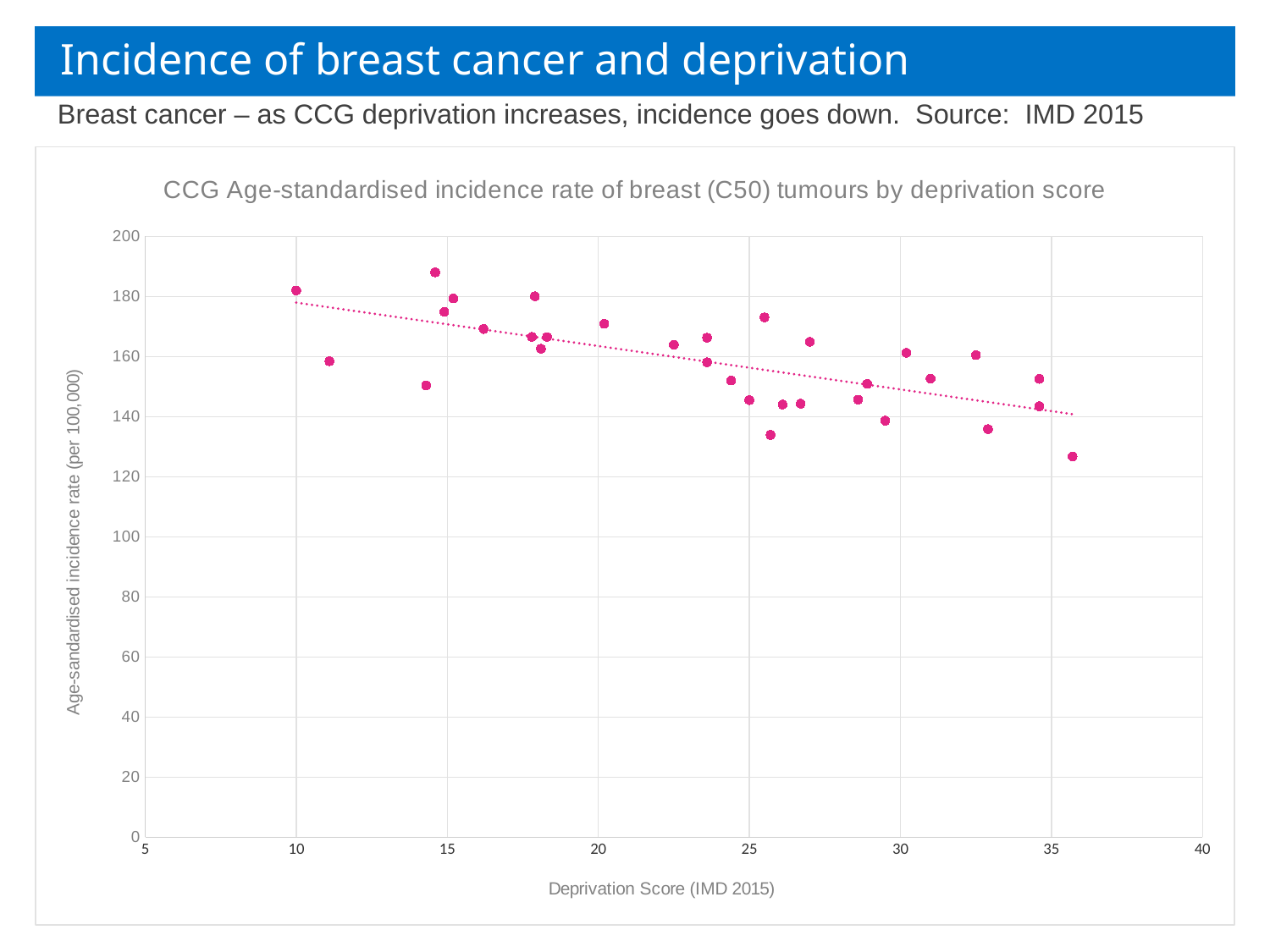
What is the maximum value shown on the y axis? 200 What kind of chart is shown on the slide? Scatter chart Is the incidence rate for the point with the lowest deprivation score (around 10) greater or less than 160? greater What is the title of the chart? CCG Age-standardised incidence rate of breast (C50) tumours by deprivation score Is the highest plotted incidence rate greater or less than 180? greater Is the incidence rate for the point with the highest deprivation score (around 36) greater or less than 140? less Does the dotted trend line slope upward or downward from left to right? Downward As the deprivation score increases along the x axis, do the incidence rates generally rise or fall? Fall What is the label of the x axis? Deprivation Score (IMD 2015)